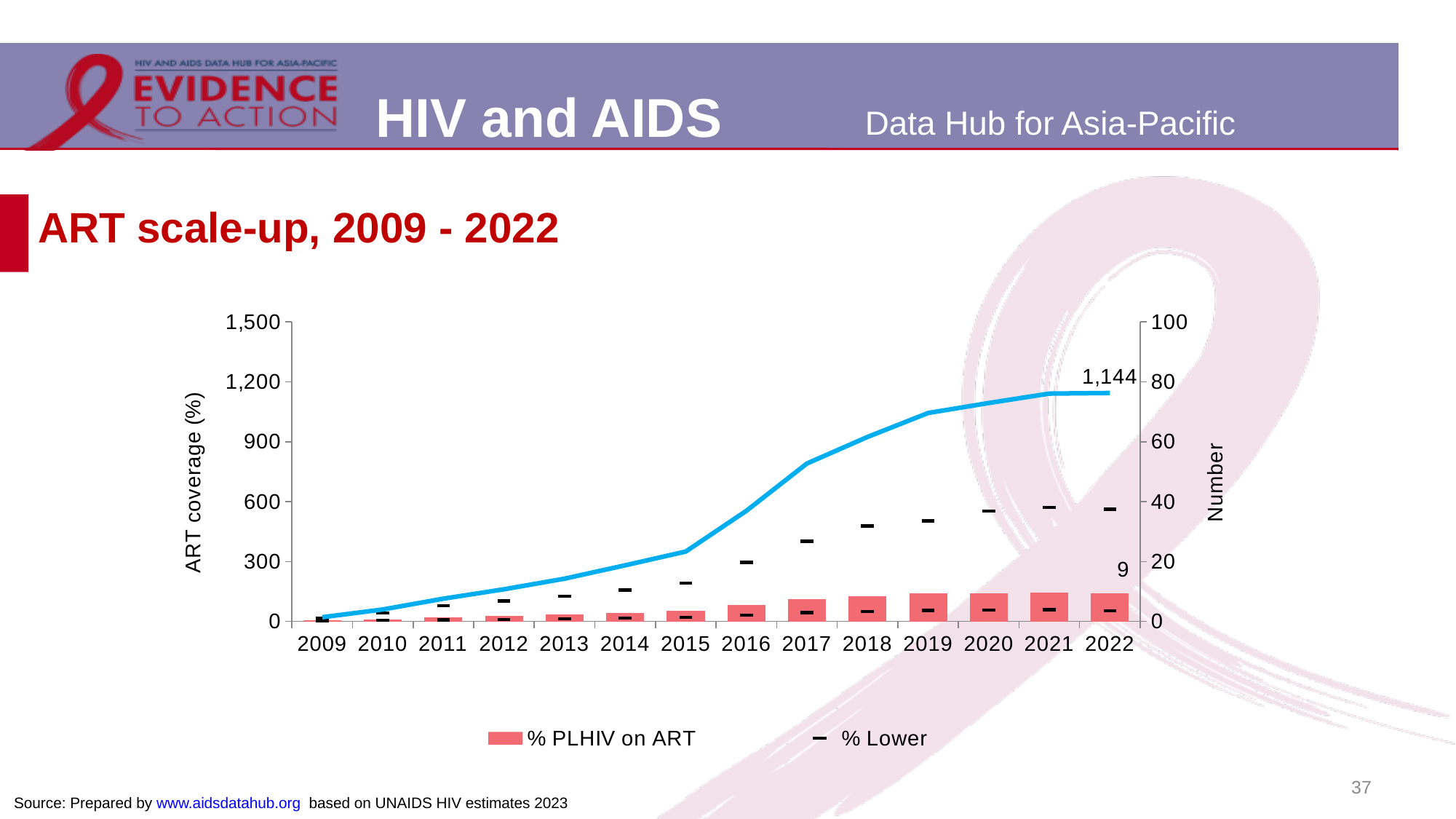
What is the title of the chart? ART scale-up, 2009 - 2022 How many years are shown on the x axis of the chart? 14 What value is labelled on the blue line for 2022? 1,144 Which year has the higher value on the blue line, 2015 or 2019? 2019 Does the blue line rise or fall from 2009 to 2022? rises Is the value of the blue line in 2012 greater or less than 300 on the left axis? less In which year is the blue line at its lowest? 2009 Is the value of the blue line in 2017 greater or less than 600 on the left axis? greater Which two series are listed in the chart legend? % PLHIV on ART and % Lower What value is labelled on the % PLHIV on ART bar for 2022? 9 How many series does the chart legend list? 2